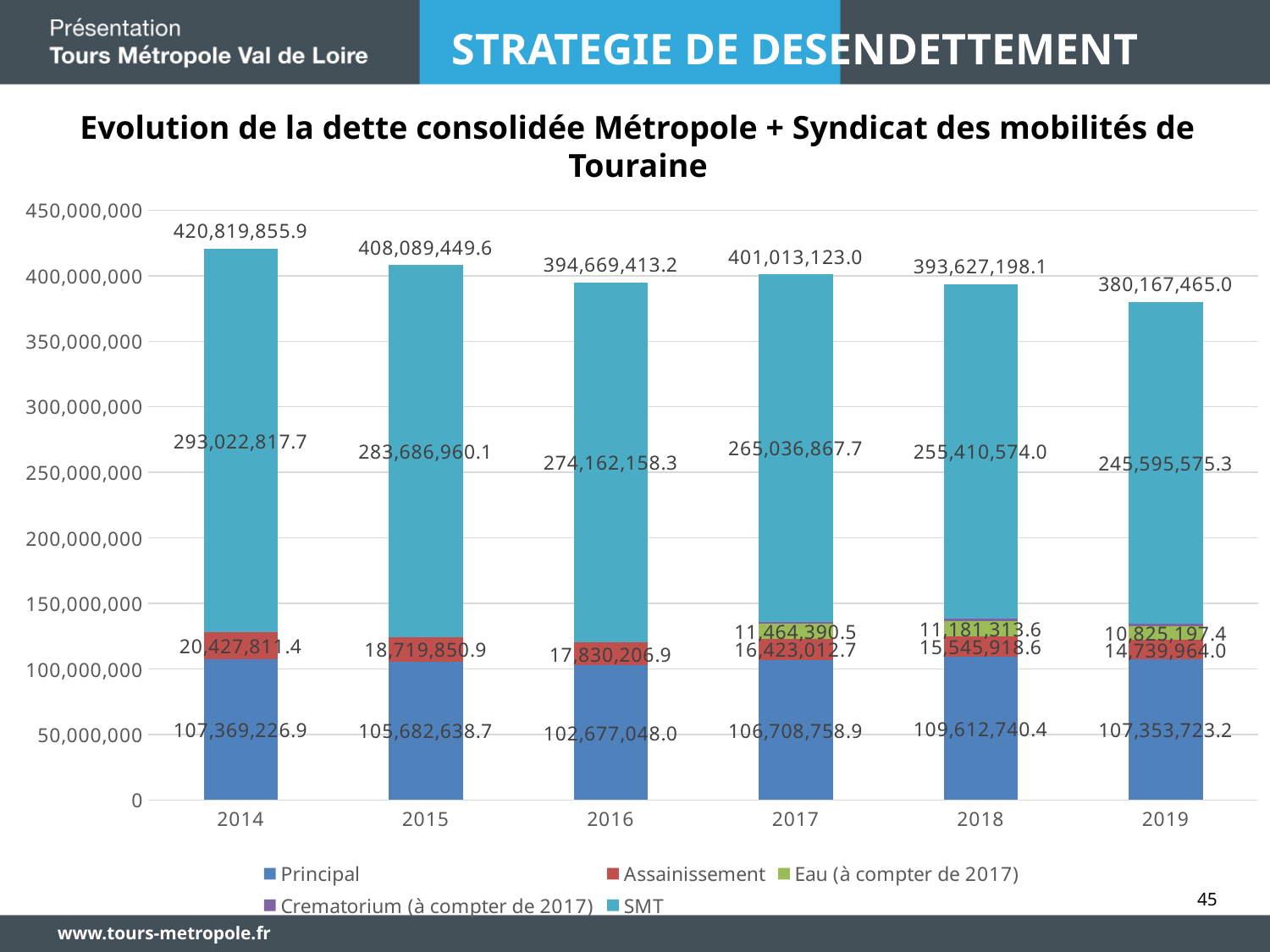
What is the SMT value for 2014? 293,022,817.7 What is the Eau (à compter de 2017) value for 2019? 10,825,197.4 Which year has the highest total consolidated debt? 2014 What is the difference between the total debt in 2014 and in 2019? 40,652,390.9 What kind of chart is shown on the slide? Stacked bar chart Does the SMT value rise or fall from 2014 to 2019? Fall What is the total consolidated debt shown above the bar for 2017? 401,013,123.0 How many series does the chart legend list? 5 How many years are shown on the x axis of the chart? 6 What is the Principal value for 2016? 102,677,048.0 Which is larger, the Principal value for 2018 or for 2014? 2018 Which year has the lowest total consolidated debt? 2019